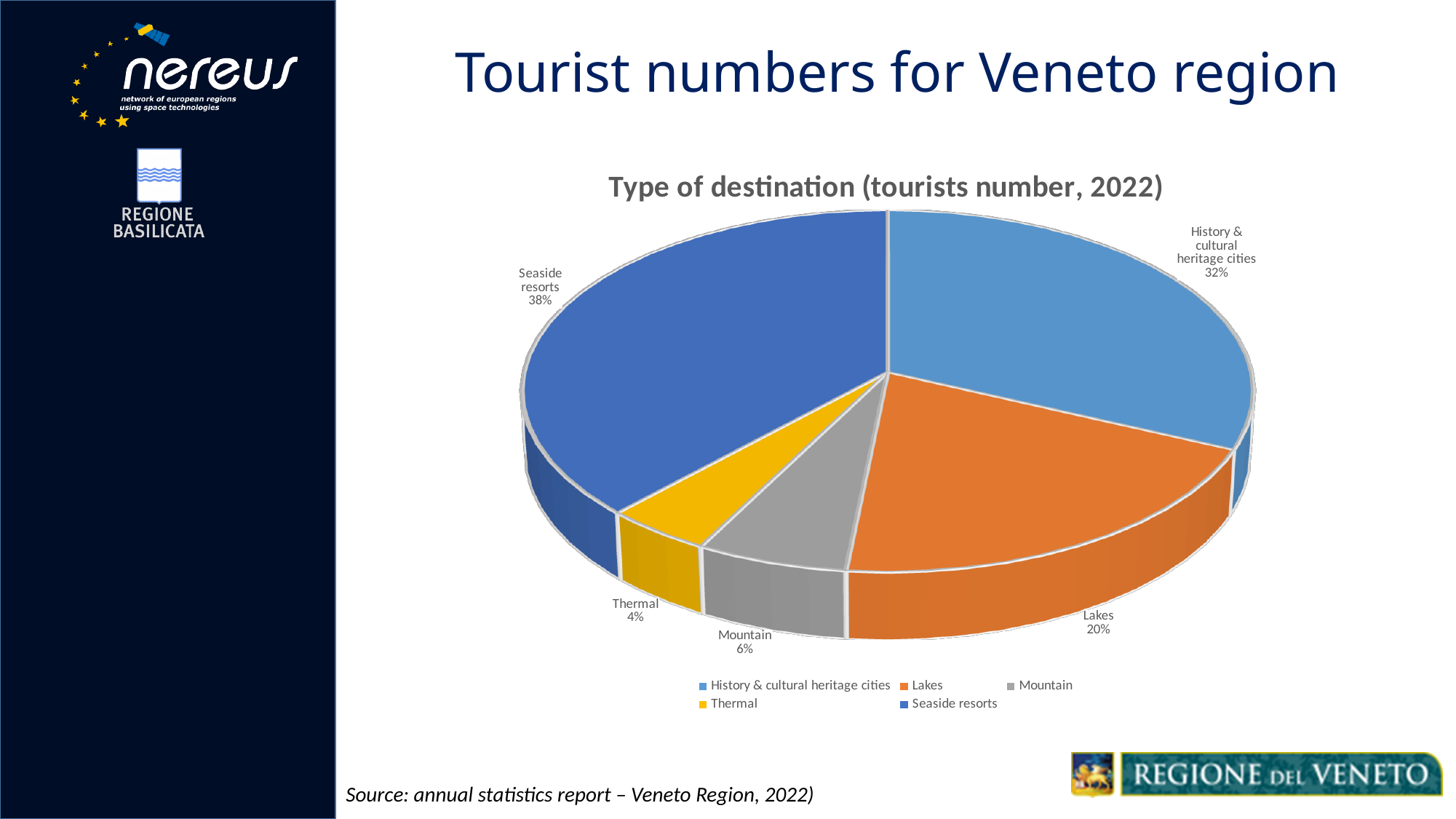
What is the difference in percentage points between seaside resorts and lakes? 18 What share of tourists went to lakes? 20% What is the title of the chart? Type of destination (tourists number, 2022) Which has a larger share, mountain or thermal? Mountain What share of tourists went to history & cultural heritage cities? 32% How many destination types are shown in the pie chart? 5 What share of tourists went to seaside resorts? 38% Which type of destination has the largest share? Seaside resorts Which type of destination has the smallest share? Thermal What kind of chart is shown on the slide? Pie chart